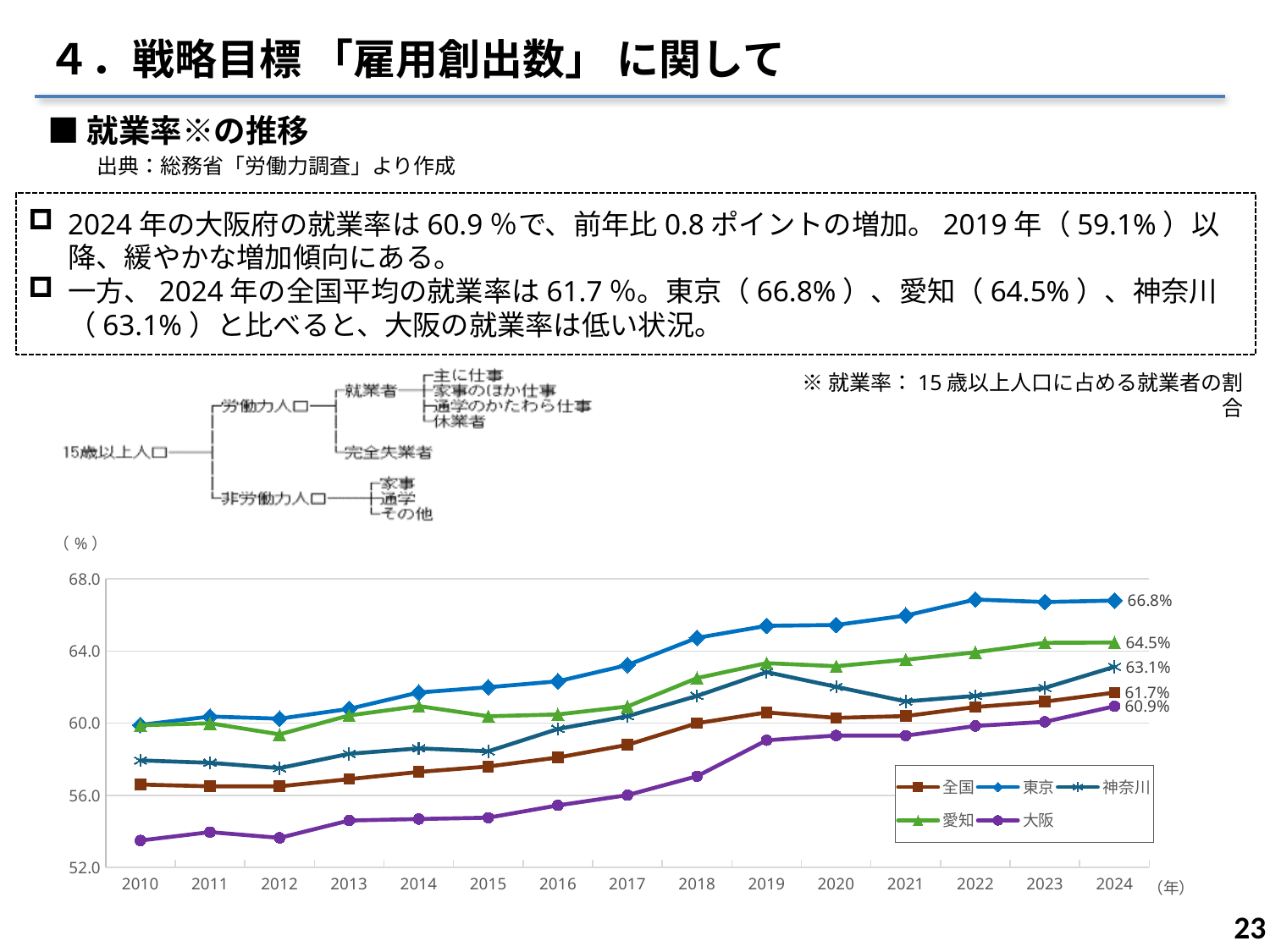
Which series has the lowest value in 2024? 大阪 What is the 2024 value for 大阪 in the chart? 60.9% Which series has the highest value in 2024? 東京 How many series does the chart legend list? 5 Does the 大阪 line generally rise or fall from 2010 to 2024? Rise In 2024, which is larger: the value for 神奈川 or the value for 全国? 神奈川 How many years are plotted along the x axis of the chart? 15 What is the difference between the 2024 values for 東京 and 大阪? 5.9 points What kind of chart is shown on the slide? Line chart Is the value for 大阪 in 2010 greater or less than 56.0? less What is the 2024 value for 愛知 in the chart? 64.5% What is the 2024 value for 東京 in the chart? 66.8%